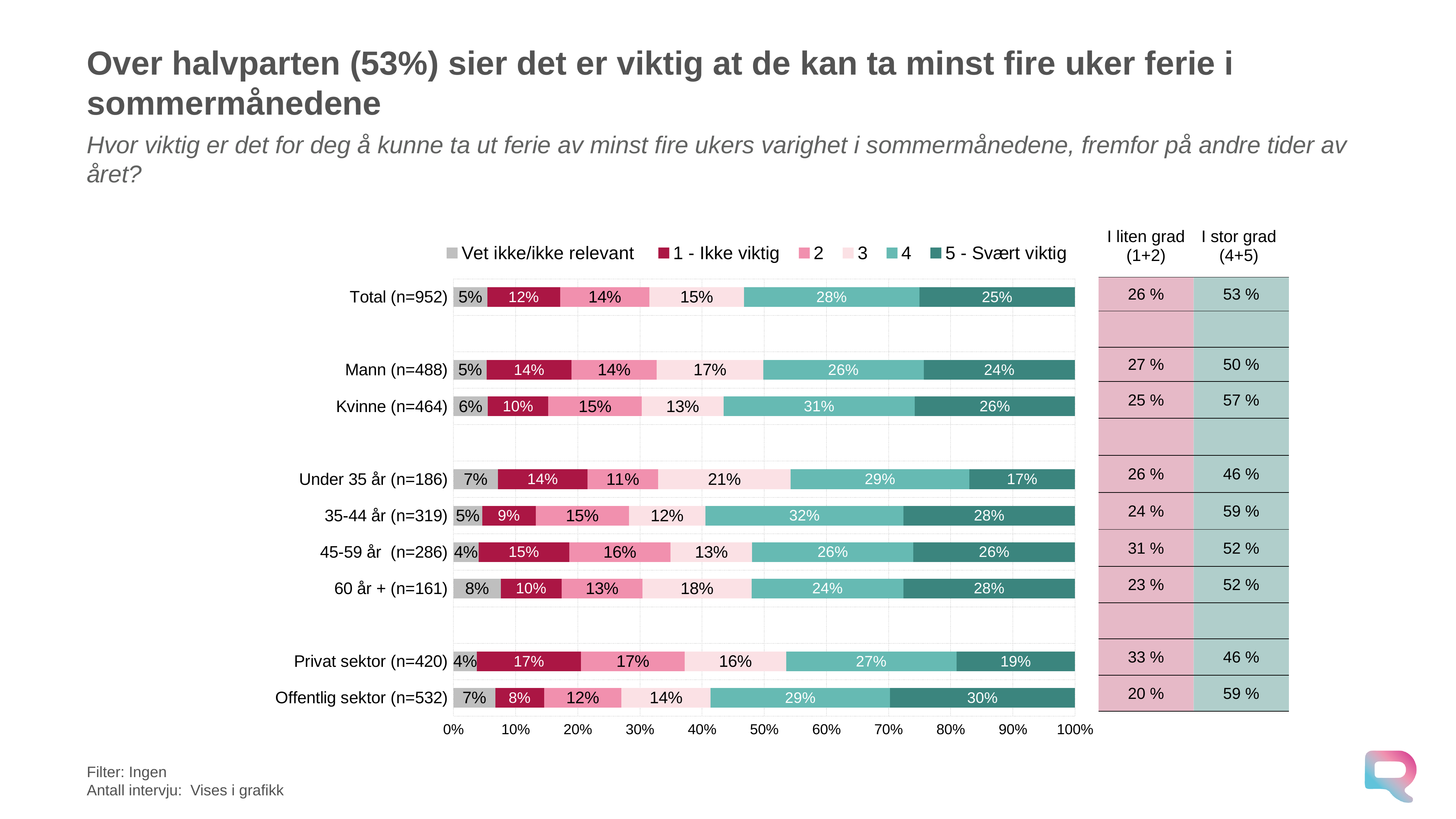
Which category has the lowest value for "5 - Svært viktig"? Under 35 år (n=186) What is the combined "I stor grad (4+5)" value shown for Total (n=952)? 53 % What is the difference between the "4" values for 35-44 år (n=319) and 60 år + (n=161)? 8% How many series does the legend list? 6 What is the value of "4" for Kvinne (n=464)? 31% Which category has the highest value for "5 - Svært viktig"? Offentlig sektor (n=532) What kind of chart is shown on the slide? Stacked bar chart What is the value of "1 - Ikke viktig" for Privat sektor (n=420)? 17% What is the value of "Vet ikke/ikke relevant" for 60 år + (n=161)? 8% What is the value of "5 - Svært viktig" for Offentlig sektor (n=532)? 30% How many categories (bars) are plotted in the chart? 9 Which is larger: the "1 - Ikke viktig" value for Mann (n=488) or for Kvinne (n=464)? Mann (n=488)